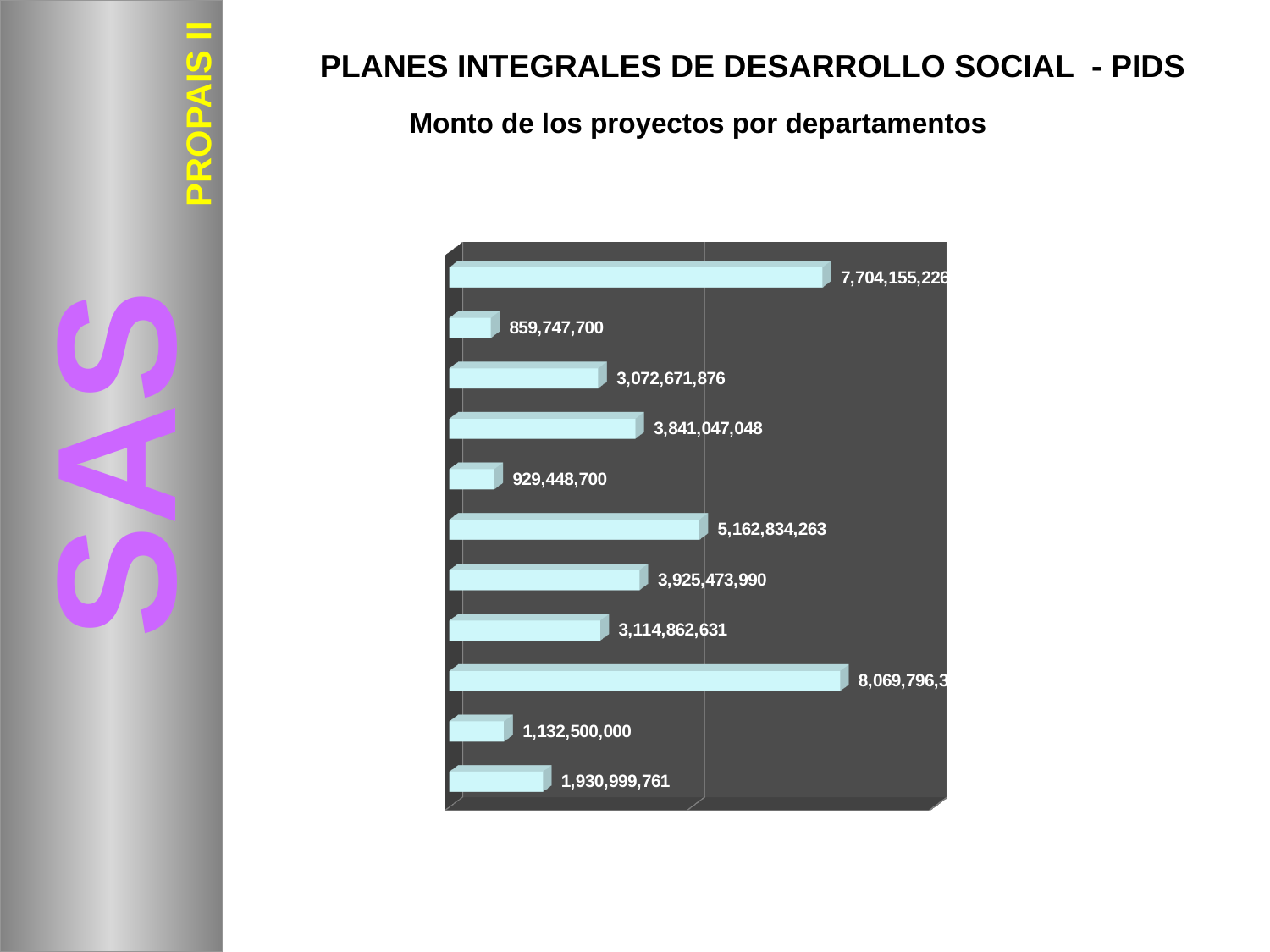
How many bars does the chart contain? 11 What value is labelled on the bottom bar of the chart? 1,930,999,761 What value is labelled on the sixth bar from the top? 5,162,834,263 What kind of chart is shown on the slide? bar chart What is the difference between the values 3,925,473,990 and 3,841,047,048 shown on the chart? 84,426,942 What is the smallest value labelled on the chart? 859,747,700 What is the difference between the bottom bar (1,930,999,761) and the bar just above it (1,132,500,000)? 798,499,761 What is the subtitle of the chart shown below the main heading? Monto de los proyectos por departamentos What value is labelled on the top bar of the chart? 7,704,155,226 Which bar is the longest in the chart: the top bar or the third bar from the bottom? the third bar from the bottom Which is larger, the value of the top bar (7,704,155,226) or the value of the sixth bar from the top (5,162,834,263)? 7,704,155,226 What value is labelled on the second bar from the top? 859,747,700